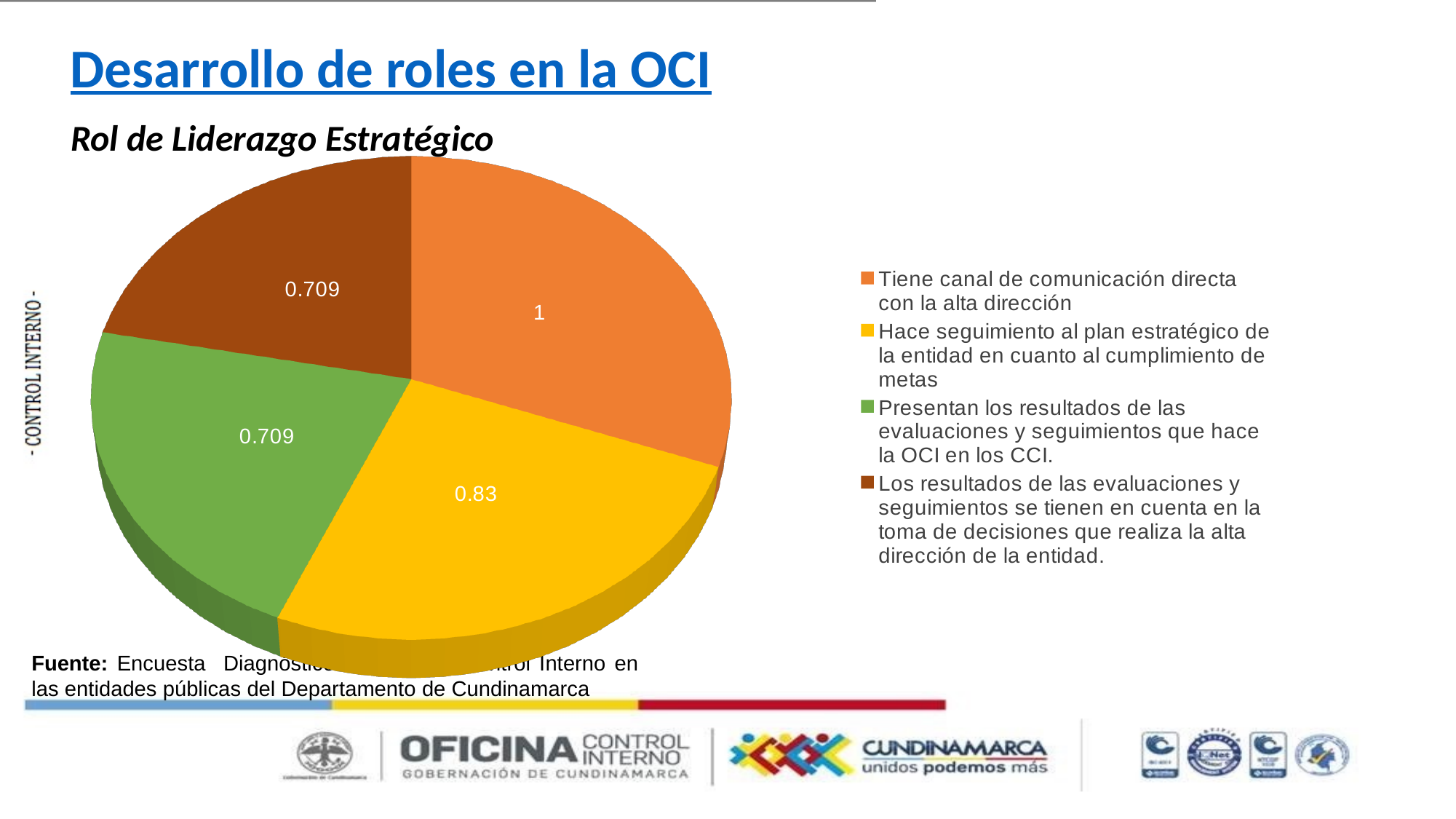
How many entries does the legend of the pie chart list? 4 What type of chart is shown on the slide? Pie chart What is the difference between the value for 'Hace seguimiento al plan estratégico de la entidad en cuanto al cumplimiento de metas' and the value for 'Presentan los resultados de las evaluaciones y seguimientos que hace la OCI en los CCI.'? 0.121 How many slices does the pie chart have? 4 Which is larger: the value for 'Tiene canal de comunicación directa con la alta dirección' or the value for 'Hace seguimiento al plan estratégico de la entidad en cuanto al cumplimiento de metas'? Tiene canal de comunicación directa con la alta dirección What is the value shown for the slice 'Presentan los resultados de las evaluaciones y seguimientos que hace la OCI en los CCI.'? 0.709 What is the value shown for the slice 'Tiene canal de comunicación directa con la alta dirección'? 1 What is the value shown for the slice 'Los resultados de las evaluaciones y seguimientos se tienen en cuenta en la toma de decisiones que realiza la alta dirección de la entidad.'? 0.709 What colour is the slice for 'Hace seguimiento al plan estratégico de la entidad en cuanto al cumplimiento de metas'? Yellow Which category has the largest slice in the pie chart? Tiene canal de comunicación directa con la alta dirección What is the difference between the value for 'Tiene canal de comunicación directa con la alta dirección' and the value for 'Hace seguimiento al plan estratégico de la entidad en cuanto al cumplimiento de metas'? 0.17 What is the value shown for the slice 'Hace seguimiento al plan estratégico de la entidad en cuanto al cumplimiento de metas'? 0.83